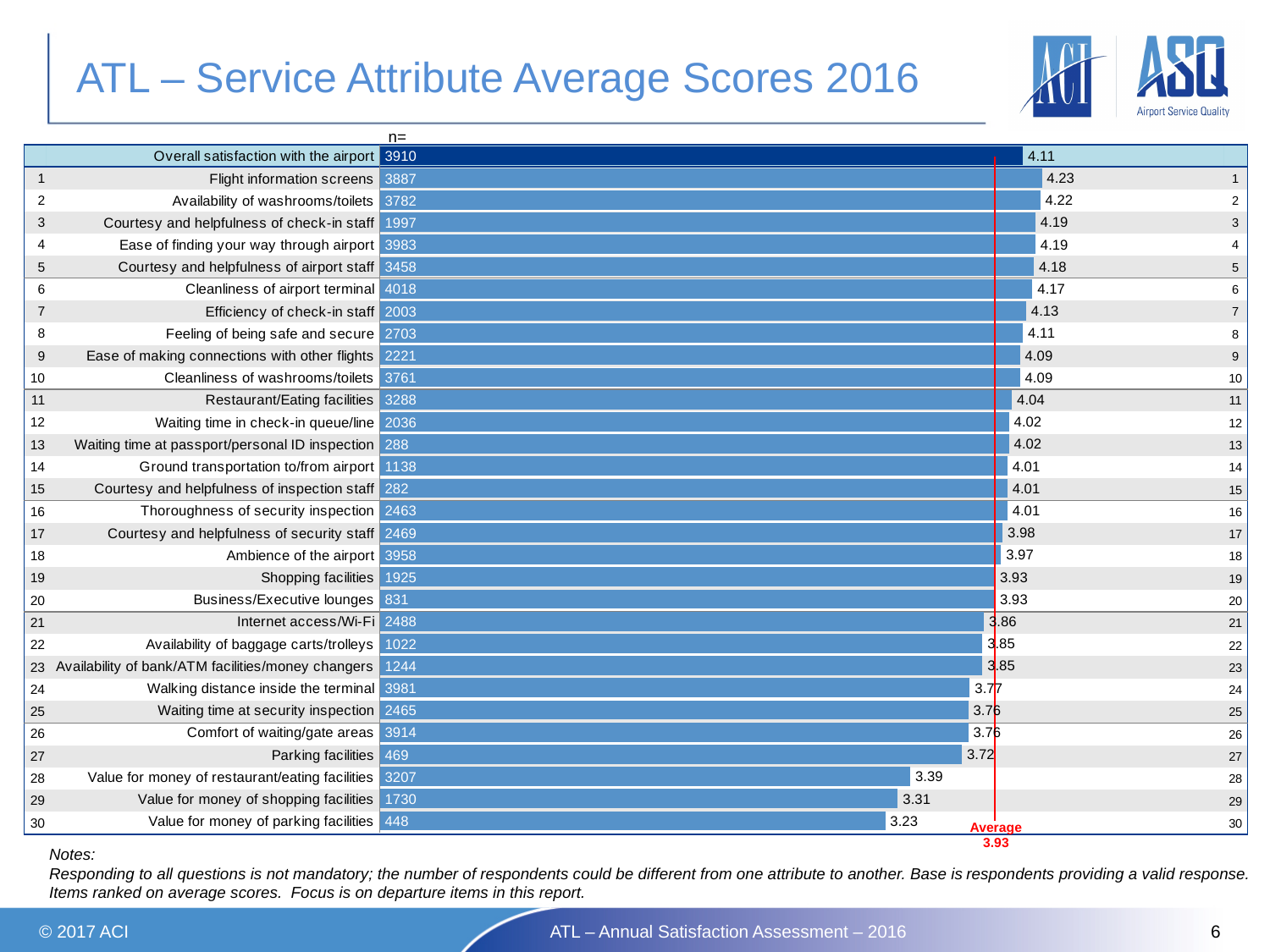
What is the average score for Flight information screens? 4.23 What is the difference between the average scores for Flight information screens and Value for money of parking facilities? 1.00 What is the overall satisfaction with the airport score? 4.11 What kind of chart is shown on the slide? Bar chart Which service attribute has the lowest average score? Value for money of parking facilities What is the average score for Value for money of parking facilities? 3.23 What is the title of the slide? ATL – Service Attribute Average Scores 2016 Which has a higher average score, Internet access/Wi-Fi or Parking facilities? Internet access/Wi-Fi What is the n= value for Parking facilities? 469 How many ranked service attributes are shown in the chart? 30 Which service attribute has the highest average score? Flight information screens What is the average value marked by the red line on the chart? 3.93